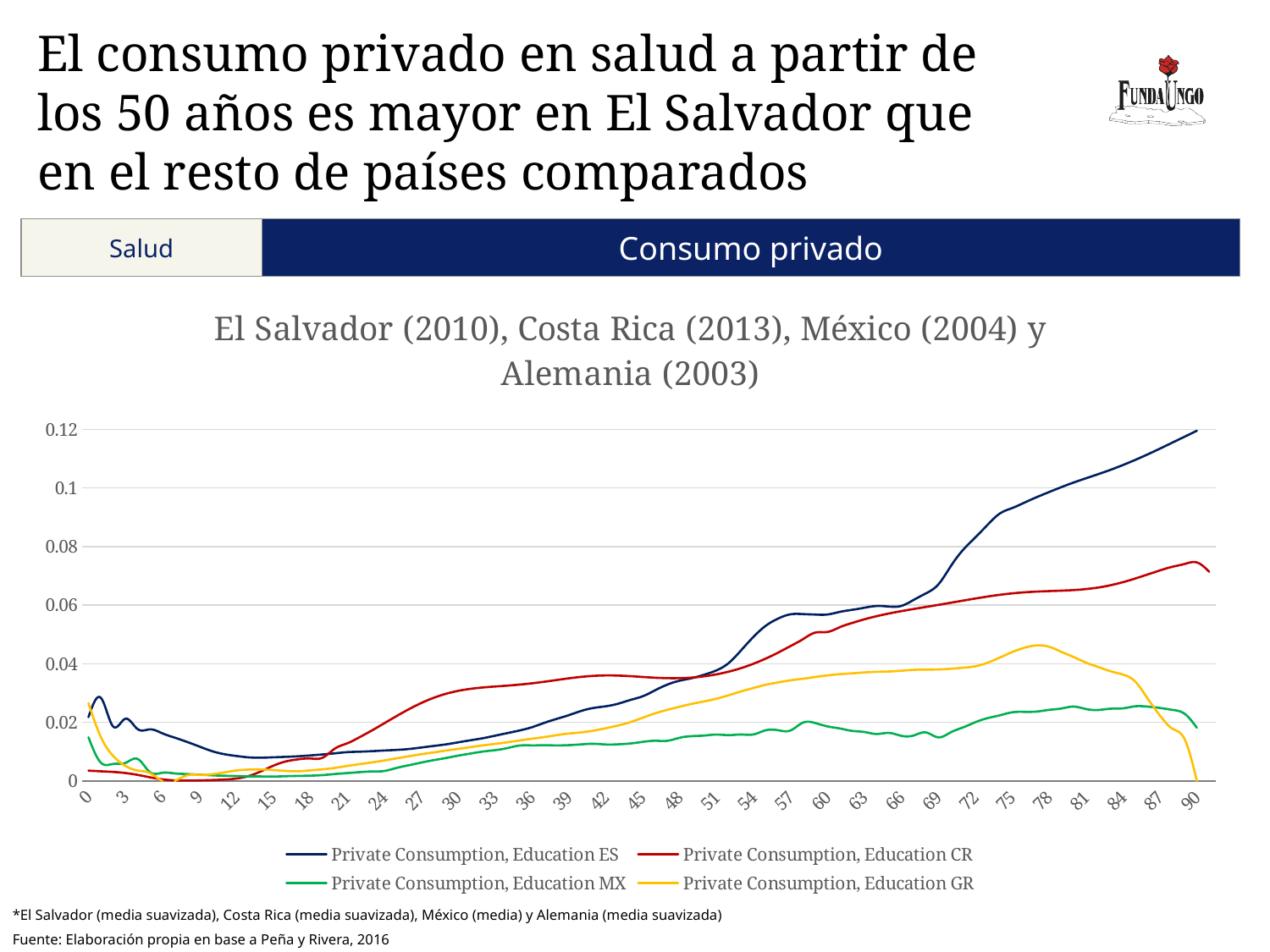
Does the Private Consumption, Education ES series rise or fall between age 50 and age 90? rise Which series reaches the highest value at age 90? Private Consumption, Education ES Which series has the lowest value at age 90? Private Consumption, Education GR Is the value for Private Consumption, Education ES at age 90 greater or less than 0.1? greater Is the value for Private Consumption, Education CR at age 90 greater or less than 0.06? greater Is the value for Private Consumption, Education MX at age 90 greater or less than 0.04? less What is the title of the chart? El Salvador (2010), Costa Rica (2013), México (2004) y Alemania (2003) How many series does the chart legend list? 4 Does the Private Consumption, Education GR series rise or fall between age 78 and age 90? fall What kind of chart is shown on the slide? line chart At age 30, which series is higher: Private Consumption, Education CR or Private Consumption, Education ES? Private Consumption, Education CR